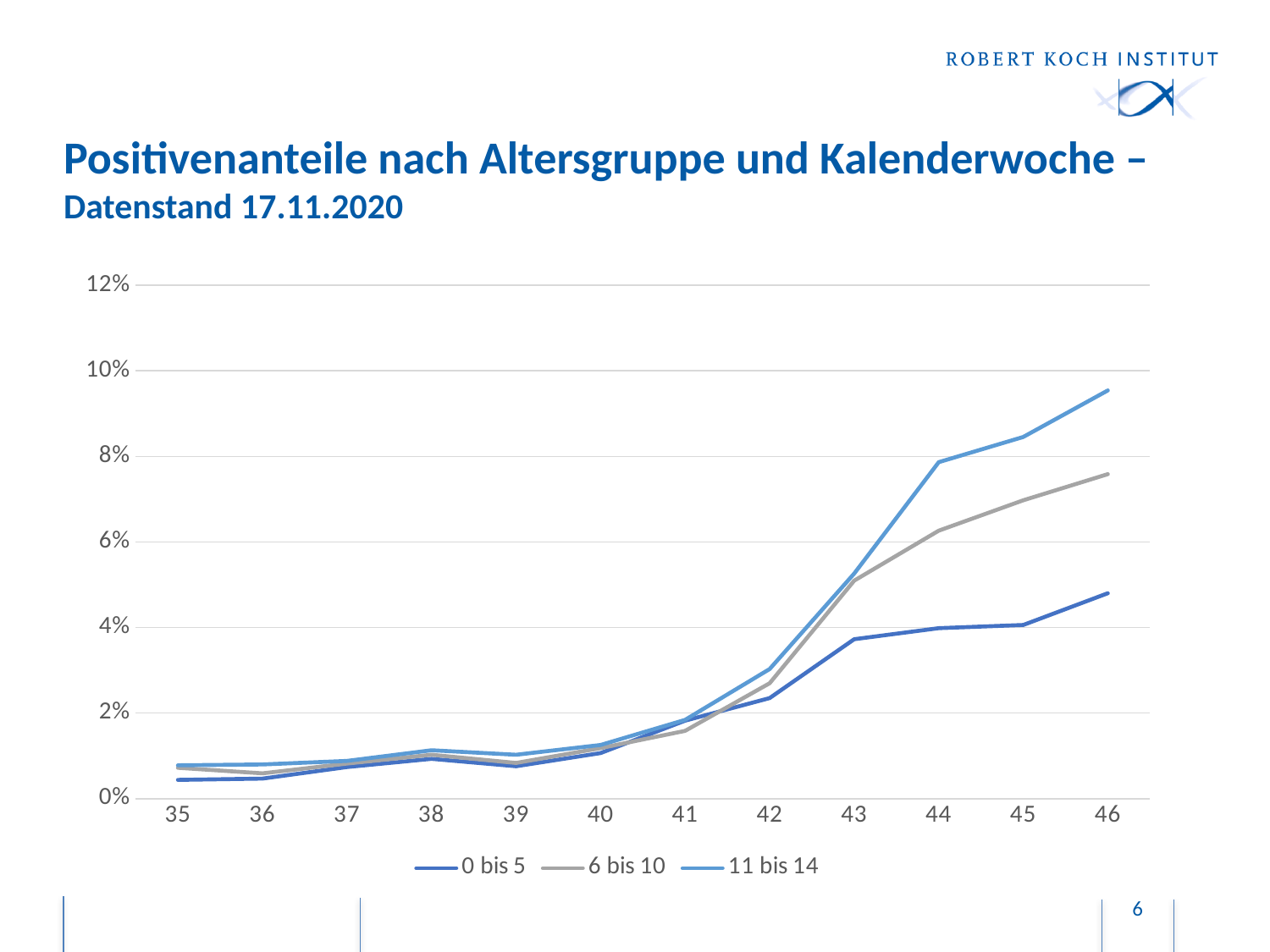
Is the value for 6 bis 10 in week 46 greater or less than 6%? greater In week 46, which is higher: 11 bis 14 or 0 bis 5? 11 bis 14 What is the title of the chart on the slide? Positivenanteile nach Altersgruppe und Kalenderwoche – Datenstand 17.11.2020 What kind of chart is shown on the slide? line chart Do the values for the series 11 bis 14 rise or fall from week 35 to week 46? rise Is the value for 11 bis 14 in week 46 greater or less than 8%? greater Which series has the lowest value in week 46? 0 bis 5 Is the value for 11 bis 14 in week 44 greater or less than 6%? greater How many series does the legend list? 3 How many calendar weeks are shown on the x axis? 12 Which series has the highest value in week 46? 11 bis 14